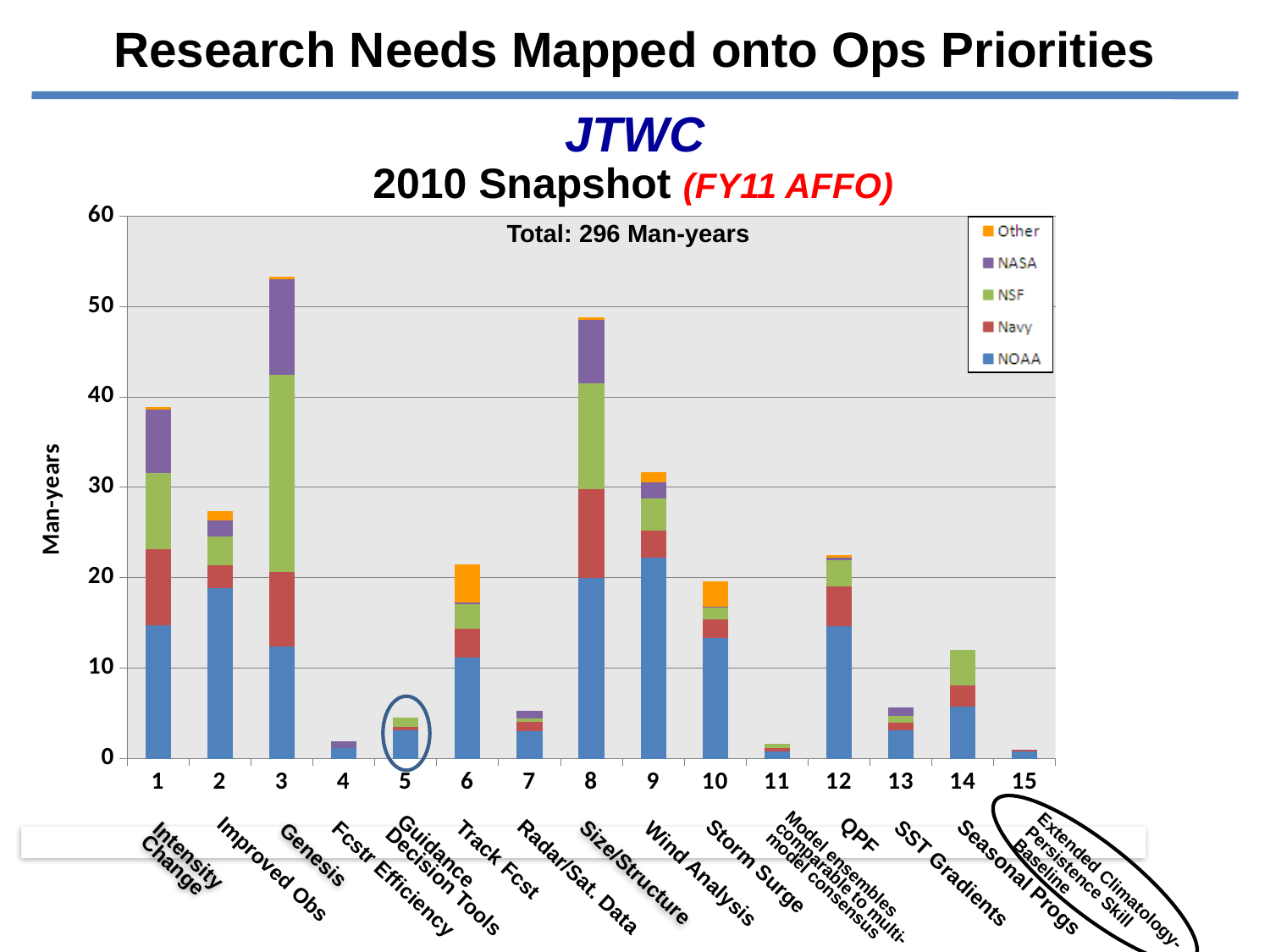
Is the total value for category 8 (Size/Structure) greater or less than 50? less Which numbered category has the tallest stacked bar? 3 (Genesis) How many series does the legend list? 5 Is the total value for category 14 (Seasonal Progs) greater or less than 10? greater Which has the larger total bar, category 9 (Wind Analysis) or category 10 (Storm Surge)? 9 (Wind Analysis) Which has the larger total bar, category 3 (Genesis) or category 8 (Size/Structure)? 3 (Genesis) How many numbered categories are plotted along the x axis? 15 What kind of chart is shown on the slide? Stacked bar chart Which series is shown in blue at the bottom of each stacked bar? NOAA Is the total value for category 9 (Wind Analysis) greater or less than 30? greater What total in man-years is printed on the chart? 296 Man-years